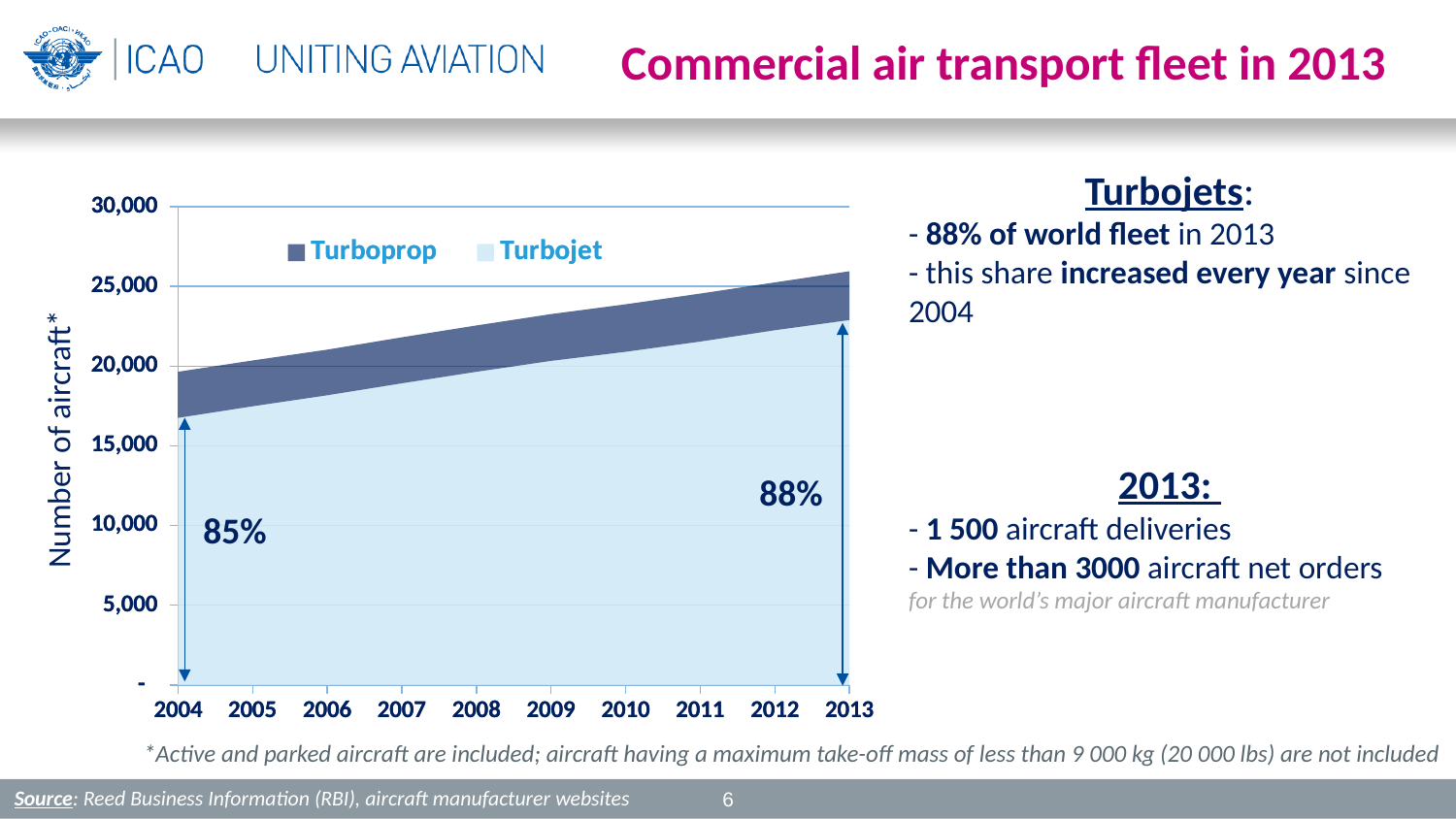
Is the Turbojet value for 2004 greater or less than 20,000? less Which year has the larger total number of aircraft, 2004 or 2013? 2013 What kind of chart is shown on the slide? Area chart What are the two series named in the chart legend? Turboprop and Turbojet Is the total number of aircraft in 2013 greater or less than 25,000? greater Does the total number of aircraft rise or fall from 2004 to 2013? Rise What percentage label is shown on the chart for 2013? 88% How many years are shown along the x axis of the chart? 10 What is the title of the y axis of the chart? Number of aircraft* How many series does the chart legend list? 2 What percentage label is shown on the chart for 2004? 85% Is the Turbojet value for 2013 greater or less than 20,000? greater